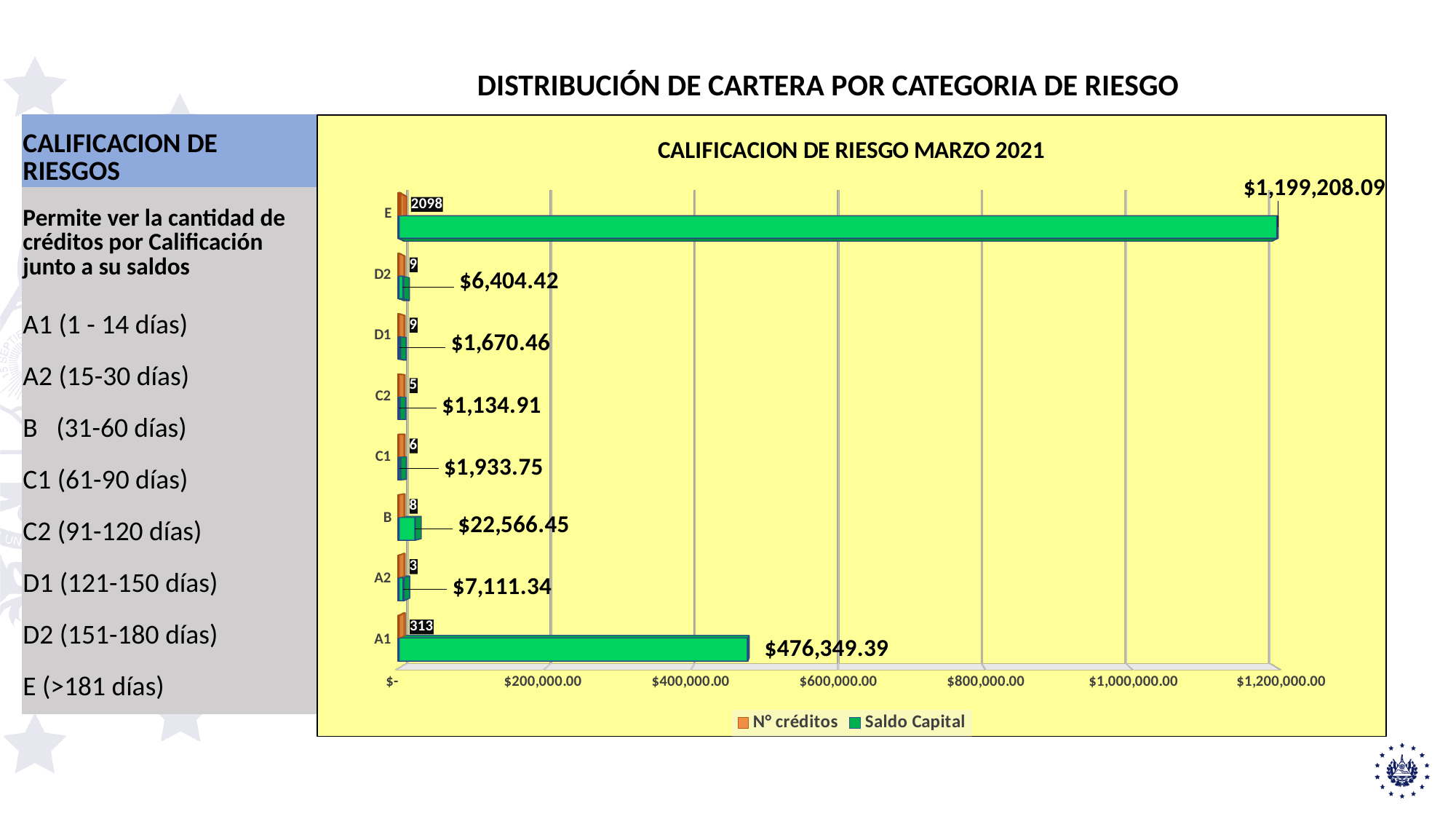
What type of chart is shown? Bar chart How many series does the legend list? 2 Which category has the lowest N° créditos? A2 What is the Saldo Capital value for category A1? $476,349.39 Which category has the lowest Saldo Capital? C2 Which has a larger Saldo Capital, category D2 or category A2? A2 How many categories are shown on the chart? 8 What is the Saldo Capital value for category B? $22,566.45 Which category has the highest Saldo Capital? E What is the difference in Saldo Capital between category E and category A1? $722,858.70 How many N° créditos are shown for category E? 2098 What is the Saldo Capital value for category E? $1,199,208.09